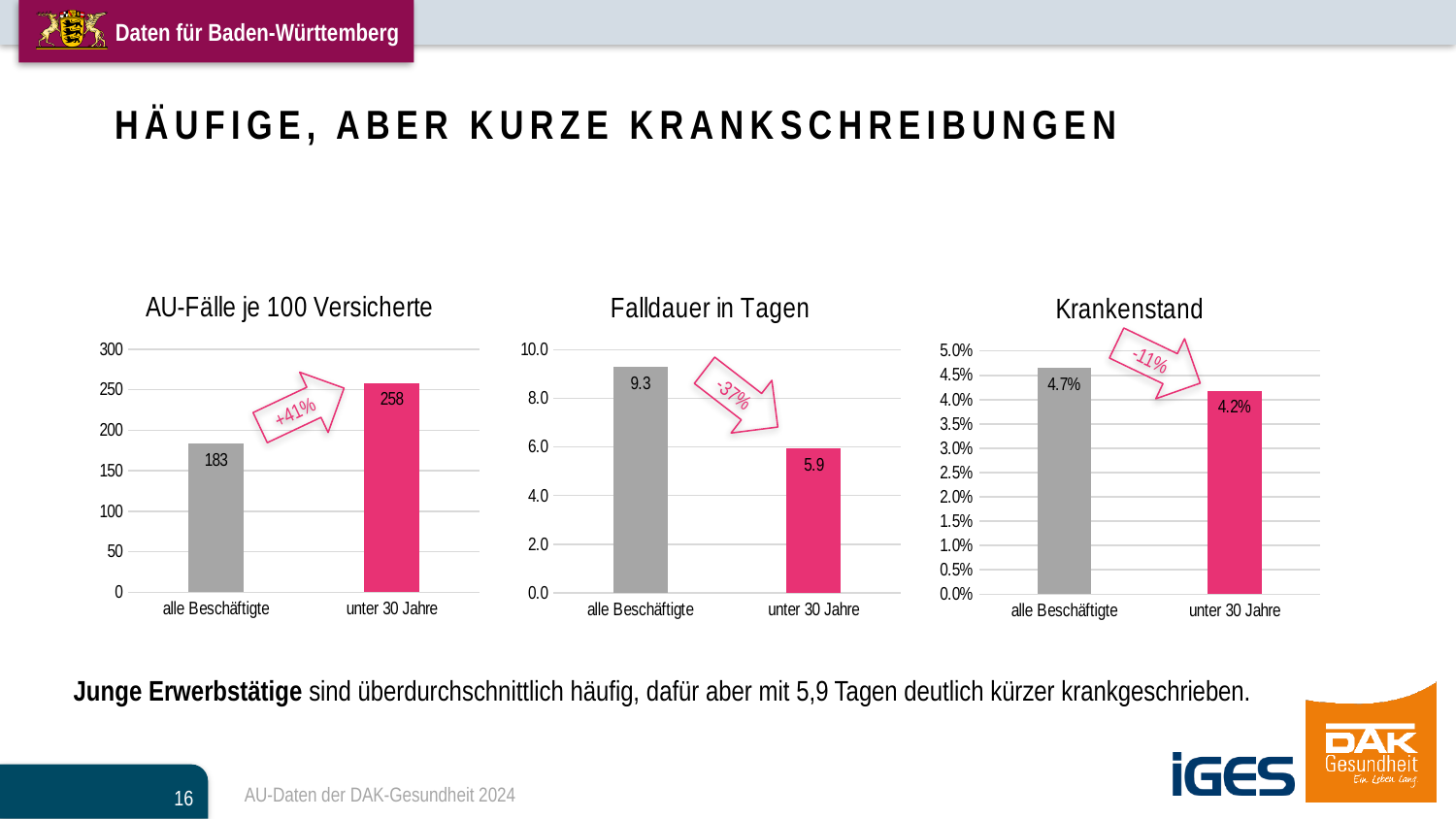
What percentage change is shown by the arrow in the 'Krankenstand' chart? -11% In the 'Krankenstand' chart, which category has the higher value? alle Beschäftigte In the 'Falldauer in Tagen' chart, what is the difference between 'alle Beschäftigte' and 'unter 30 Jahre'? 3.4 In the 'AU-Fälle je 100 Versicherte' chart, what is the value for 'unter 30 Jahre'? 258 In the 'Krankenstand' chart, what is the value for 'unter 30 Jahre'? 4.2% In the 'Falldauer in Tagen' chart, which is larger: 'alle Beschäftigte' or 'unter 30 Jahre'? alle Beschäftigte In the 'Falldauer in Tagen' chart, what is the value for 'alle Beschäftigte'? 9.3 How many categories does the 'Krankenstand' chart show? 2 In the 'AU-Fälle je 100 Versicherte' chart, what is the difference between 'unter 30 Jahre' and 'alle Beschäftigte'? 75 In the 'Falldauer in Tagen' chart, what is the value for 'unter 30 Jahre'? 5.9 What kind of chart is the 'AU-Fälle je 100 Versicherte' chart? bar chart In the 'AU-Fälle je 100 Versicherte' chart, what is the value for 'alle Beschäftigte'? 183